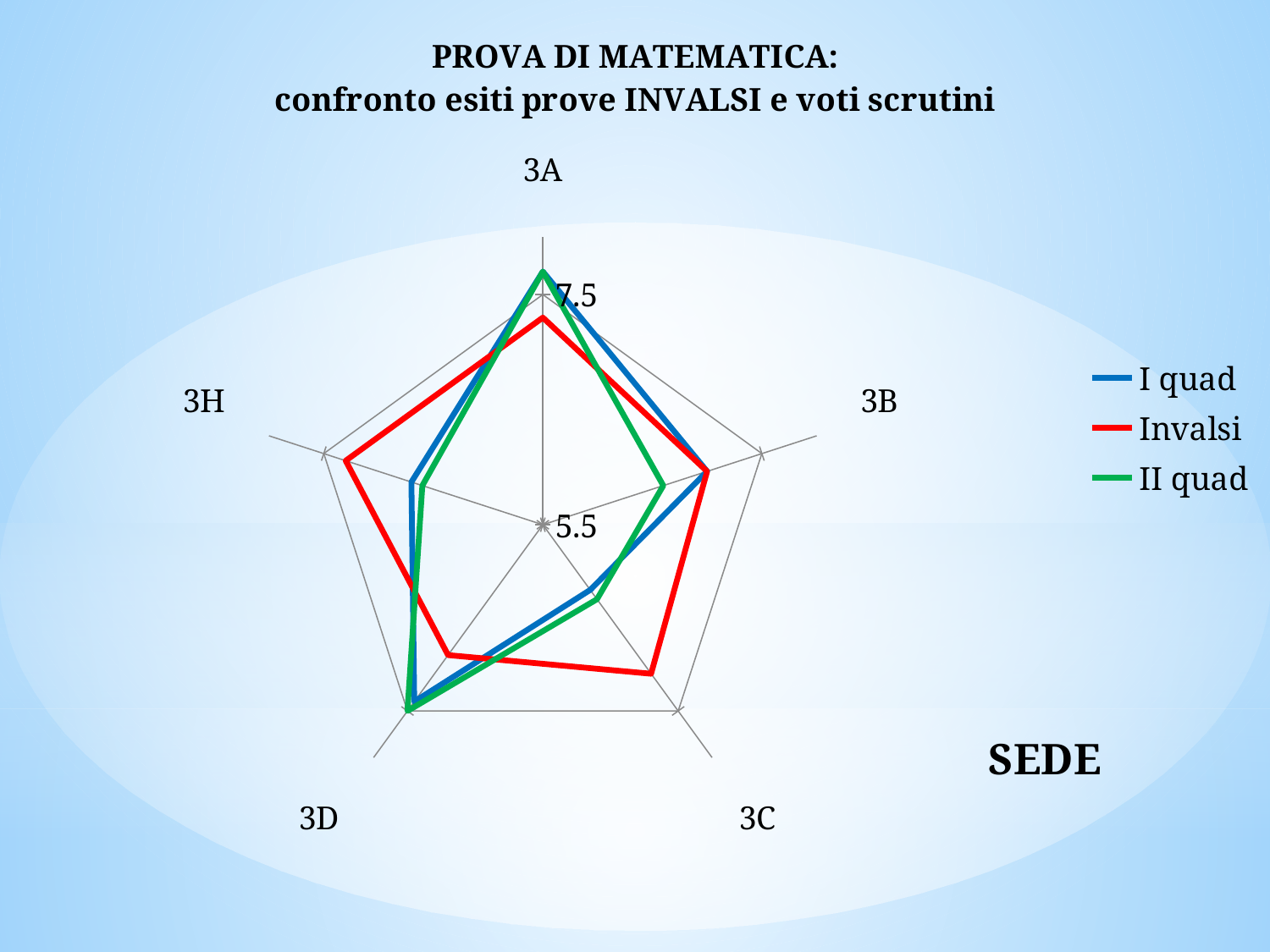
For class 3C, which series has the higher value: Invalsi or II quad? Invalsi For the I quad series, which class has the lowest value? 3C For class 3A, which series has the higher value: I quad or Invalsi? I quad What kind of chart is shown on the slide? Radar chart For class 3B, which series has the higher value: Invalsi or II quad? Invalsi For the II quad series, which class has the lowest value? 3C What is the title of the chart? PROVA DI MATEMATICA: confronto esiti prove INVALSI e voti scrutini How many classes (categories) are plotted on the radar chart? 5 Which colour represents the Invalsi series in the legend? Red For the I quad series, which class has the highest value? 3A How many series does the legend list? 3